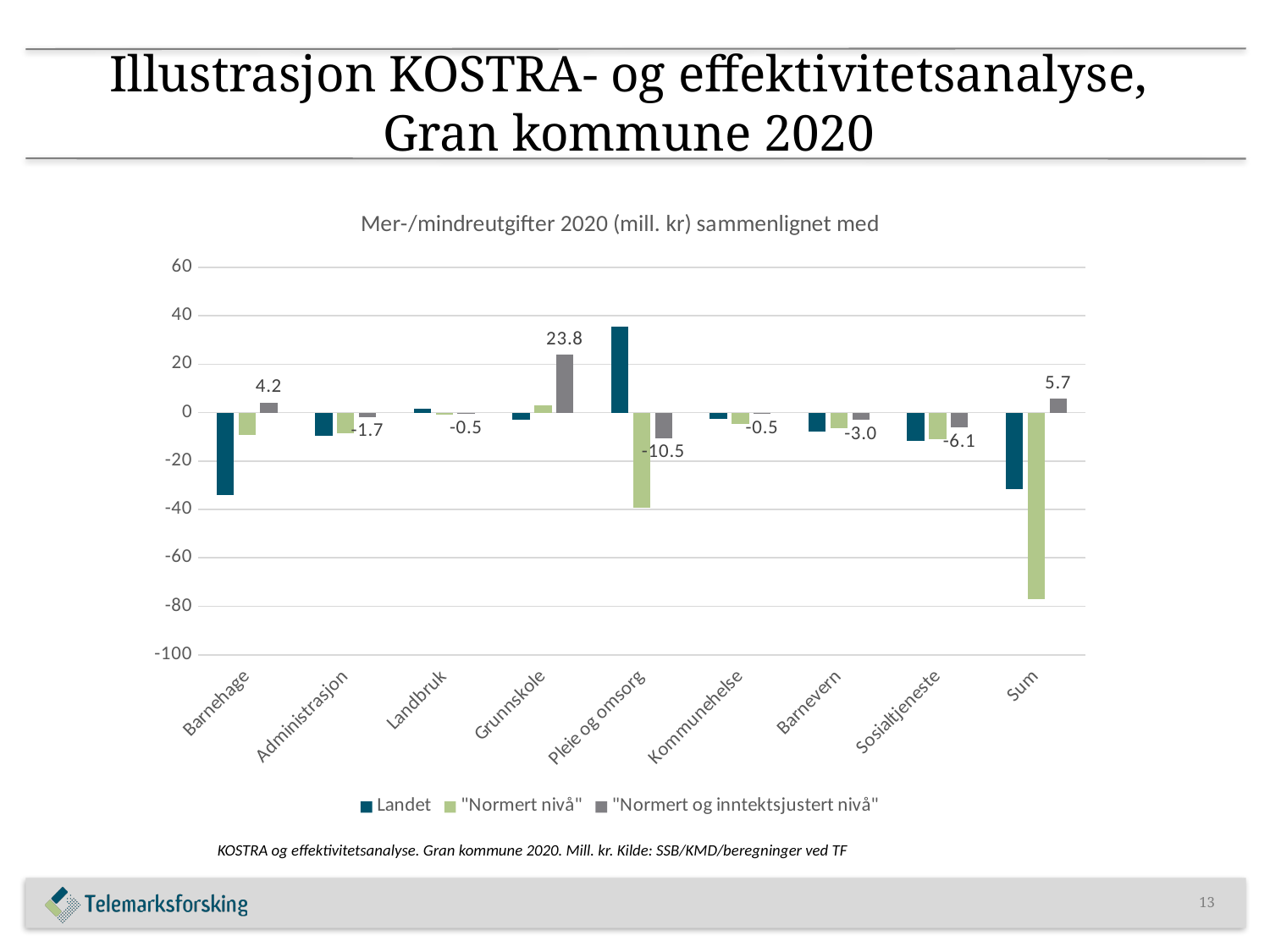
Is the "Normert nivå" value for Sum greater or less than -60? less How many categories are shown on the x axis? 9 What is the difference between the "Normert og inntektsjustert nivå" values for Grunnskole and Sum? 18.1 What is the value for "Normert og inntektsjustert nivå" for Sum? 5.7 How many series does the legend list? 3 What is the value for "Normert og inntektsjustert nivå" for Sosialtjeneste? -6.1 Which category has the lowest value for "Normert og inntektsjustert nivå"? Pleie og omsorg What is the value for "Normert og inntektsjustert nivå" for Grunnskole? 23.8 Which category has the highest value for "Normert og inntektsjustert nivå"? Grunnskole What is the value for "Normert og inntektsjustert nivå" for Pleie og omsorg? -10.5 Is the Landet value for Barnehage greater or less than -20? less For "Normert og inntektsjustert nivå", which is larger: Barnehage or Sum? Sum